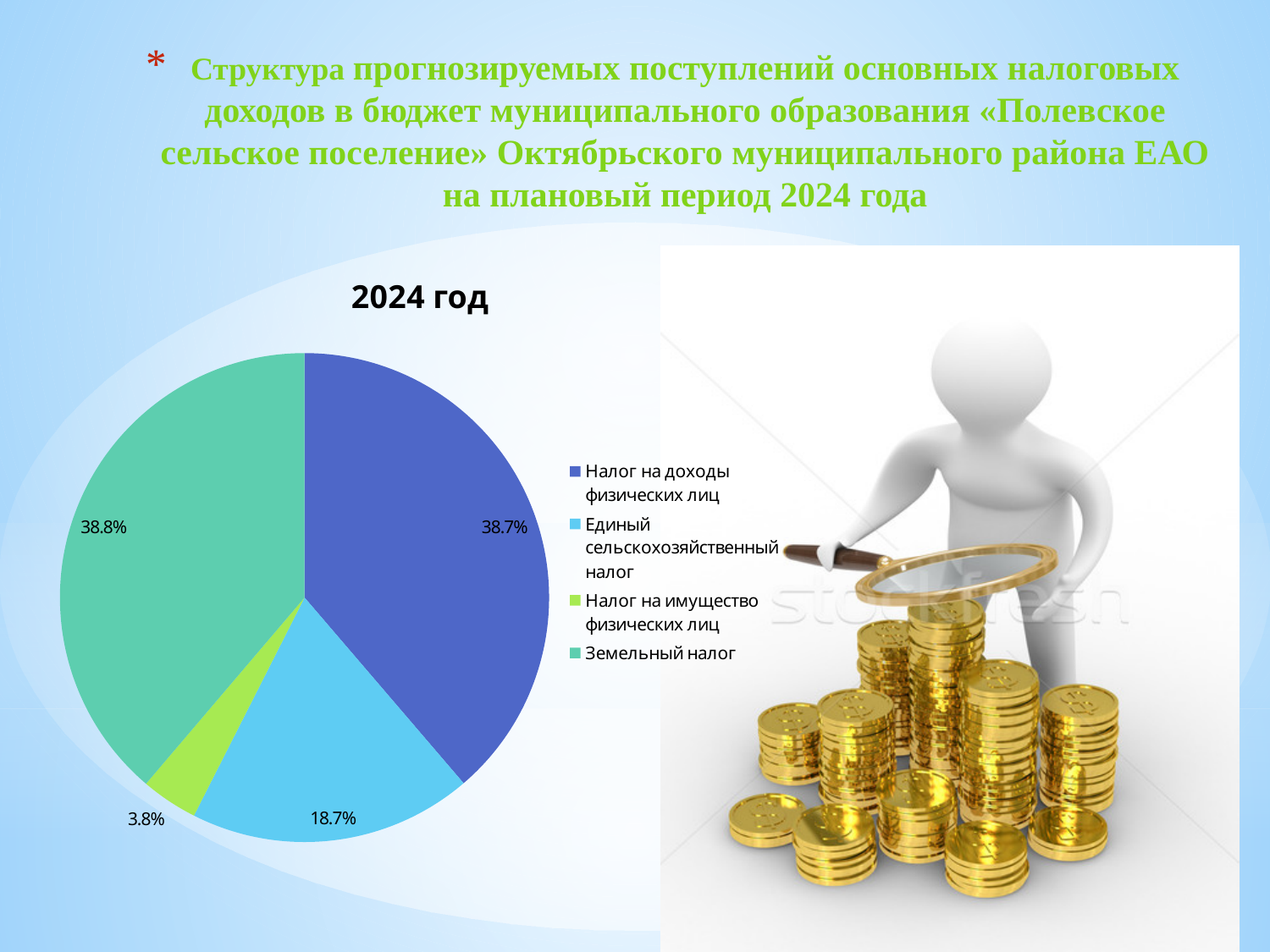
What share of the pie is Земельный налог? 38.8% What kind of chart is shown on the slide? pie chart What is the title of the chart? 2024 год What share of the pie is Налог на доходы физических лиц? 38.7% What share of the pie is Налог на имущество физических лиц? 3.8% What is the difference in percentage points between Налог на доходы физических лиц and Единый сельскохозяйственный налог? 20.0 How many slices does the pie chart have? 4 Which category has the smallest share of the pie? Налог на имущество физических лиц Which is larger: the share for Единый сельскохозяйственный налог or the share for Налог на имущество физических лиц? Единый сельскохозяйственный налог What share of the pie is Единый сельскохозяйственный налог? 18.7% How many entries does the legend list? 4 Which colour represents Земельный налог in the legend? teal (green-blue)